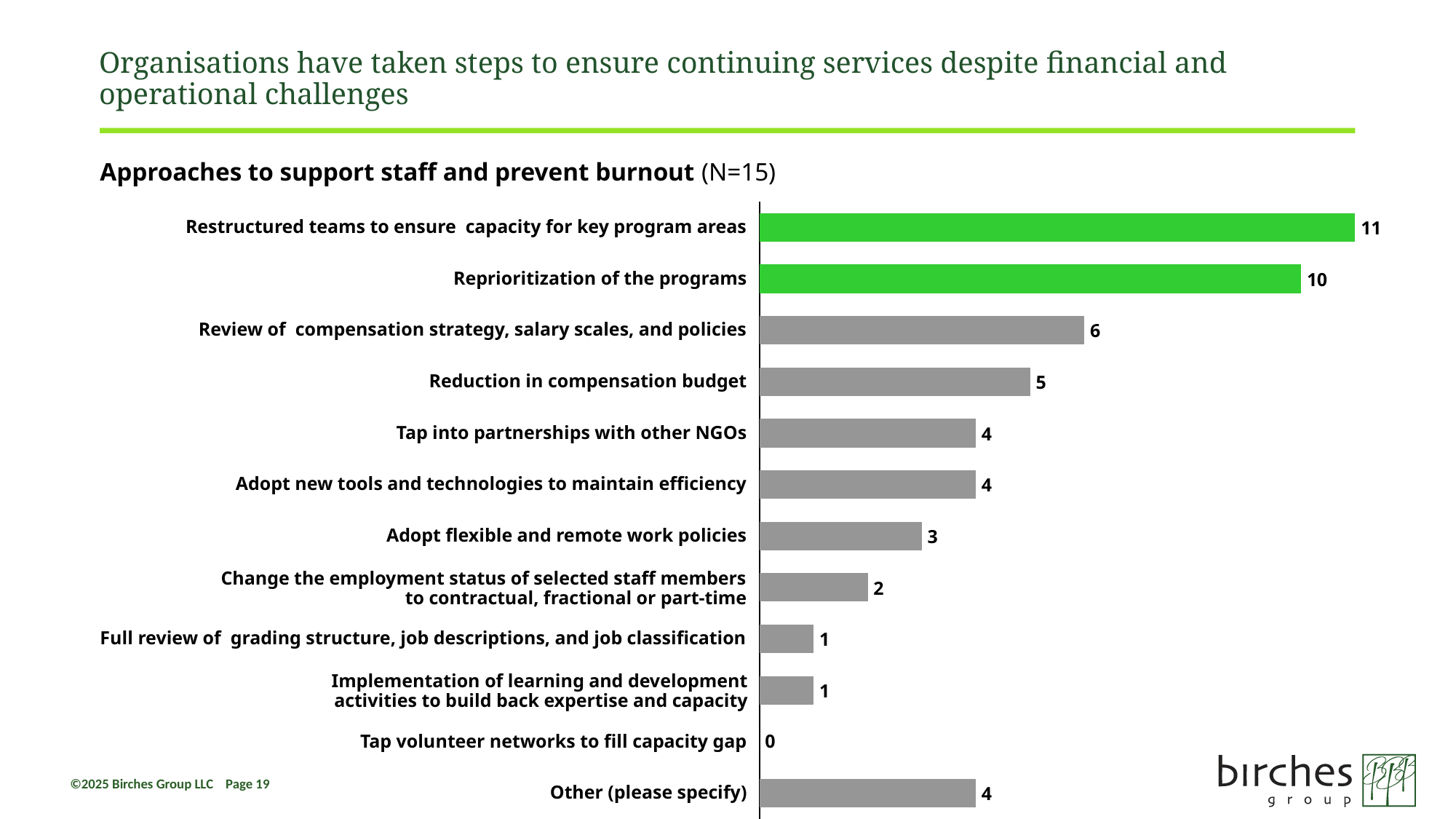
What is the value for "Reprioritization of the programs"? 10 What is the difference between "Restructured teams to ensure capacity for key program areas" and "Review of compensation strategy, salary scales, and policies"? 5 Which approach has the highest value? Restructured teams to ensure capacity for key program areas How many approaches (categories) are shown in the chart? 12 What is the value for "Adopt flexible and remote work policies"? 3 Which is larger: "Reduction in compensation budget" or "Tap into partnerships with other NGOs"? Reduction in compensation budget Which approach has the lowest value? Tap volunteer networks to fill capacity gap What is the value for "Reduction in compensation budget"? 5 What is the value for "Tap volunteer networks to fill capacity gap"? 0 How many bars are coloured green? 2 What is the title of the chart? Approaches to support staff and prevent burnout (N=15) What kind of chart is shown on the slide? Bar chart